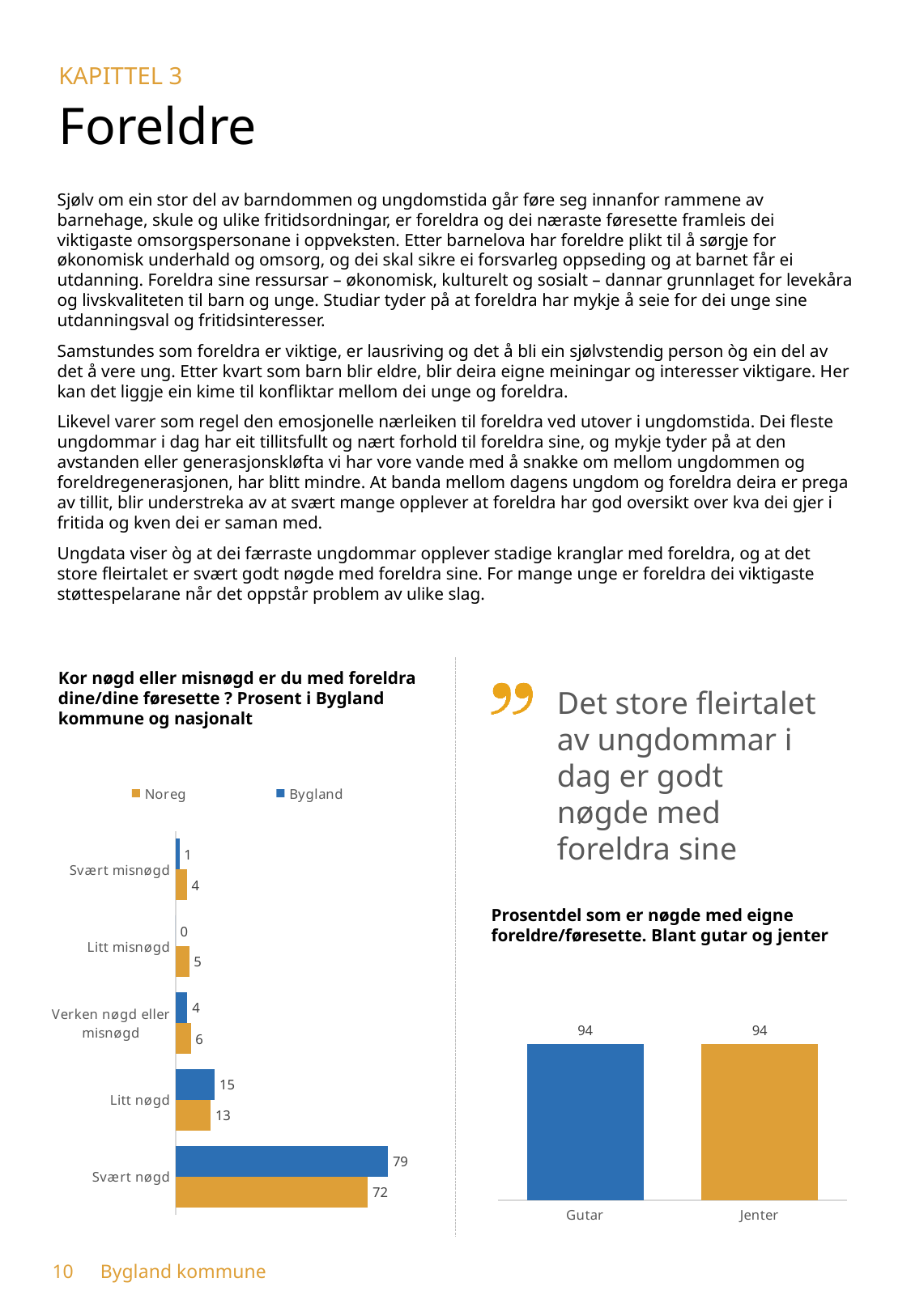
In the left chart (Kor nøgd eller misnøgd er du med foreldra dine), what is the Bygland value for Litt misnøgd? 0 In the left chart (Kor nøgd eller misnøgd er du med foreldra dine), what is the Noreg value for Svært nøgd? 72 In the left chart (Kor nøgd eller misnøgd er du med foreldra dine), what is the Bygland value for Svært nøgd? 79 In the right chart (Prosentdel som er nøgde med eigne foreldre/føresette), what is the value for Jenter? 94 In the left chart (Kor nøgd eller misnøgd er du med foreldra dine), how many categories are shown? 5 In the left chart (Kor nøgd eller misnøgd er du med foreldra dine), which is larger for Litt nøgd, Bygland or Noreg? Bygland In the left chart (Kor nøgd eller misnøgd er du med foreldra dine), which category has the highest Bygland value? Svært nøgd In the left chart (Kor nøgd eller misnøgd er du med foreldra dine), which category has the lowest Noreg value? Svært misnøgd In the left chart (Kor nøgd eller misnøgd er du med foreldra dine), what is the Noreg value for Verken nøgd eller misnøgd? 6 In the left chart (Kor nøgd eller misnøgd er du med foreldra dine), what is the difference between the Bygland and Noreg values for Svært nøgd? 7 In the left chart (Kor nøgd eller misnøgd er du med foreldra dine), how many series does the legend list? 2 What kind of chart is the right chart (Prosentdel som er nøgde med eigne foreldre/føresette)? Bar chart